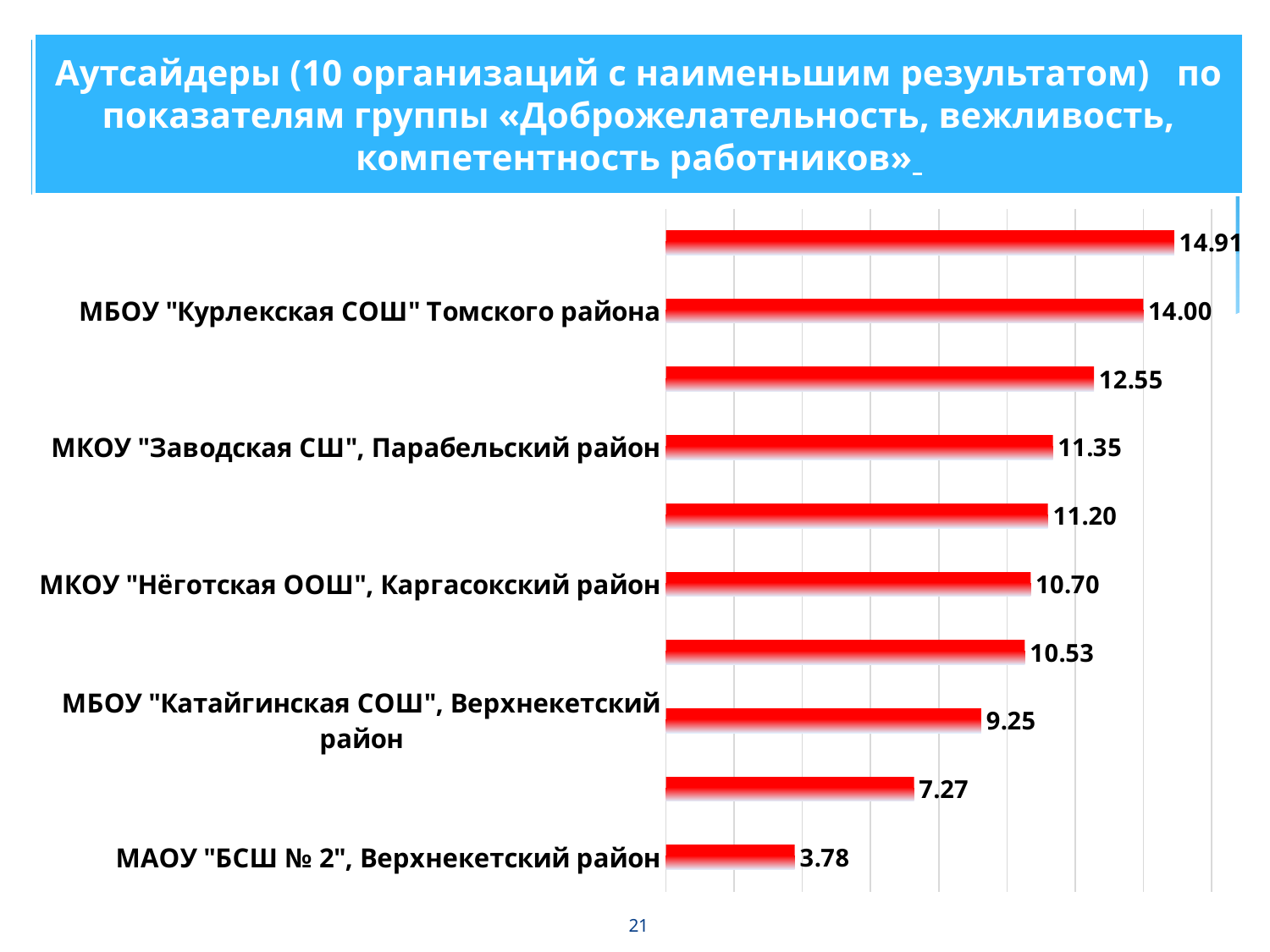
What is the value for МКОУ "Нёготская ООШ", Каргасокский район? 10.70 What is the difference between the values for МБОУ "Курлекская СОШ" Томского района and МАОУ "БСШ № 2", Верхнекетский район? 10.22 What is the value for МАОУ "БСШ № 2", Верхнекетский район? 3.78 What is the value for МБОУ "Курлекская СОШ" Томского района? 14.00 What kind of chart is shown on the slide? Bar chart What is the highest value shown on the chart? 14.91 What is the value for МКОУ "Заводская СШ", Парабельский район? 11.35 What colour are the bars on the chart? Red Which has a larger value: МКОУ "Заводская СШ", Парабельский район or МБОУ "Катайгинская СОШ", Верхнекетский район? МКОУ "Заводская СШ", Парабельский район What is the value for МБОУ "Катайгинская СОШ", Верхнекетский район? 9.25 How many bars are plotted on the chart? 10 Which organisation has the lowest value on the chart? МАОУ "БСШ № 2", Верхнекетский район